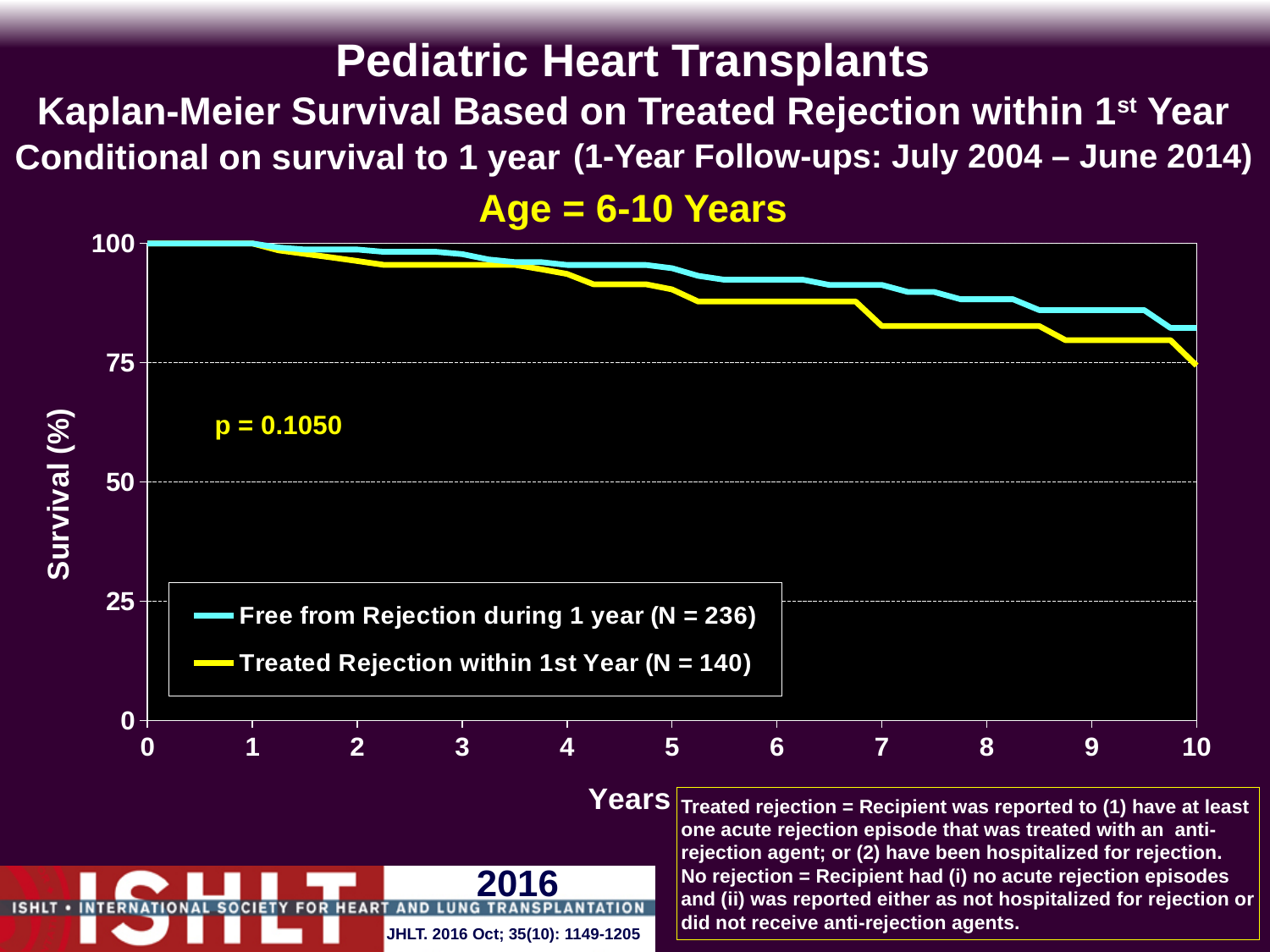
Do the survival curves rise or fall as years increase? fall Is the survival for the Treated Rejection within 1st Year group at year 5 greater or less than 75? greater What is the label of the y axis? Survival (%) Is the survival for the Free from Rejection during 1 year group at year 3 greater or less than 90? greater What is the N for the 'Free from Rejection during 1 year' group? 236 At year 7, which group has the higher survival: Free from Rejection during 1 year or Treated Rejection within 1st Year? Free from Rejection during 1 year How many series does the legend list? 2 What is the p-value shown on the chart? p = 0.1050 What kind of chart is shown on the slide? line chart What is the N for the 'Treated Rejection within 1st Year' group? 140 Which colour is used for the Treated Rejection within 1st Year line? yellow Is the survival for the Free from Rejection during 1 year group at year 10 greater or less than 75? greater